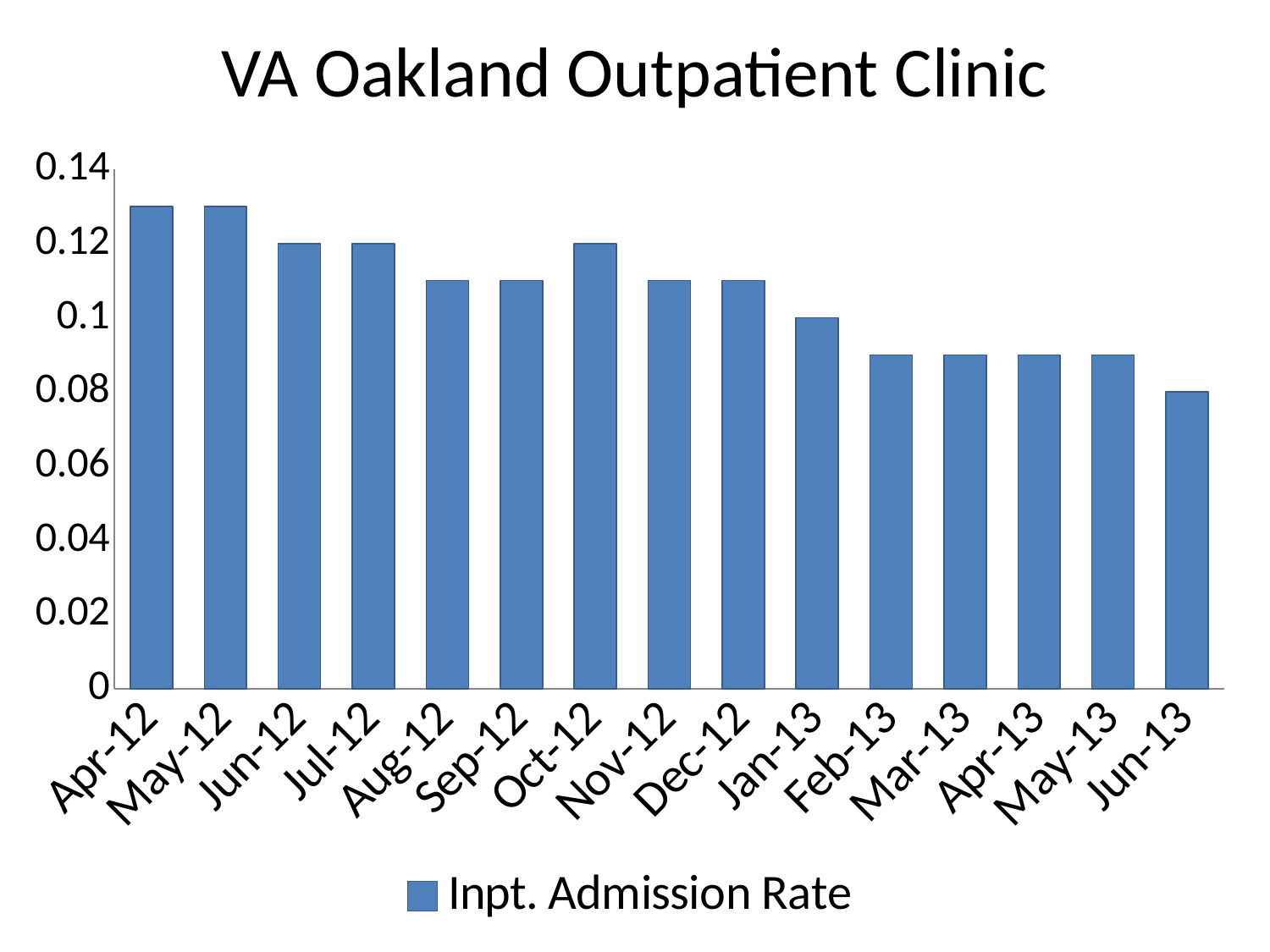
How many months are plotted on the x axis? 15 Overall, do the values rise or fall from Apr-12 to Jun-13? Fall Is the value for Apr-12 greater or less than 0.12? greater Which month has the lowest Inpt. Admission Rate? Jun-13 What is the Inpt. Admission Rate for Jun-13? 0.08 What is the Inpt. Admission Rate for Jun-12? 0.12 What is the title of the chart? VA Oakland Outpatient Clinic What series name does the legend show? Inpt. Admission Rate Is the value for Feb-13 greater or less than 0.1? less Which is larger, the value for Oct-12 or the value for Nov-12? Oct-12 What type of chart is shown on the slide? Bar chart How many series does the legend list? 1